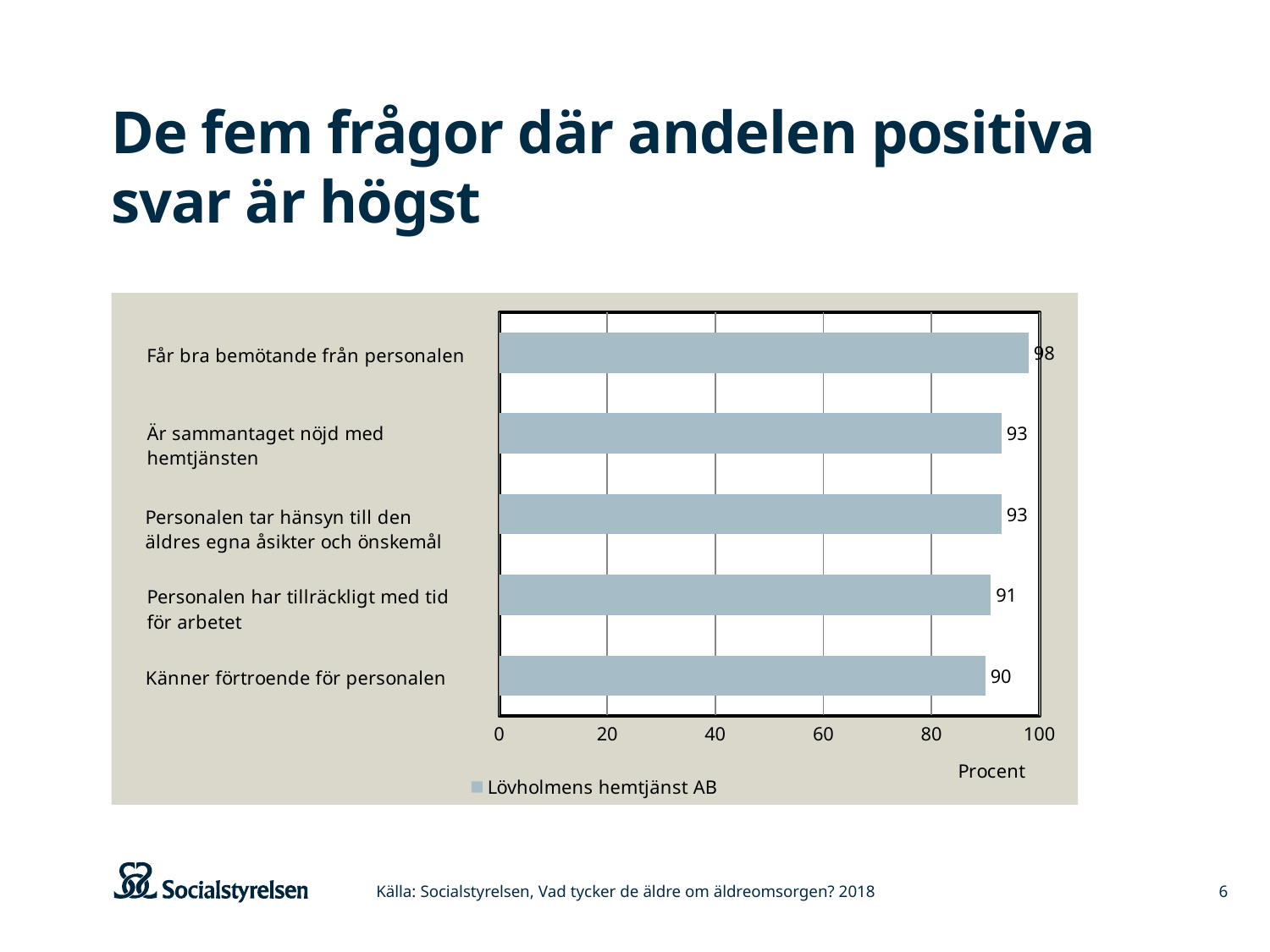
What is the value for "Får bra bemötande från personalen"? 98 What is the value for "Personalen har tillräckligt med tid för arbetet"? 91 Which category has the highest value? Får bra bemötande från personalen What is the value for "Känner förtroende för personalen"? 90 What series name is shown in the legend? Lövholmens hemtjänst AB Which category has the lowest value? Känner förtroende för personalen How many categories are shown in the chart? 5 What is the difference between the values for "Får bra bemötande från personalen" and "Känner förtroende för personalen"? 8 What is the value for "Är sammantaget nöjd med hemtjänsten"? 93 What kind of chart is shown on the slide? Bar chart How many series does the legend list? 1 Which is larger: the value for "Får bra bemötande från personalen" or the value for "Personalen har tillräckligt med tid för arbetet"? Får bra bemötande från personalen